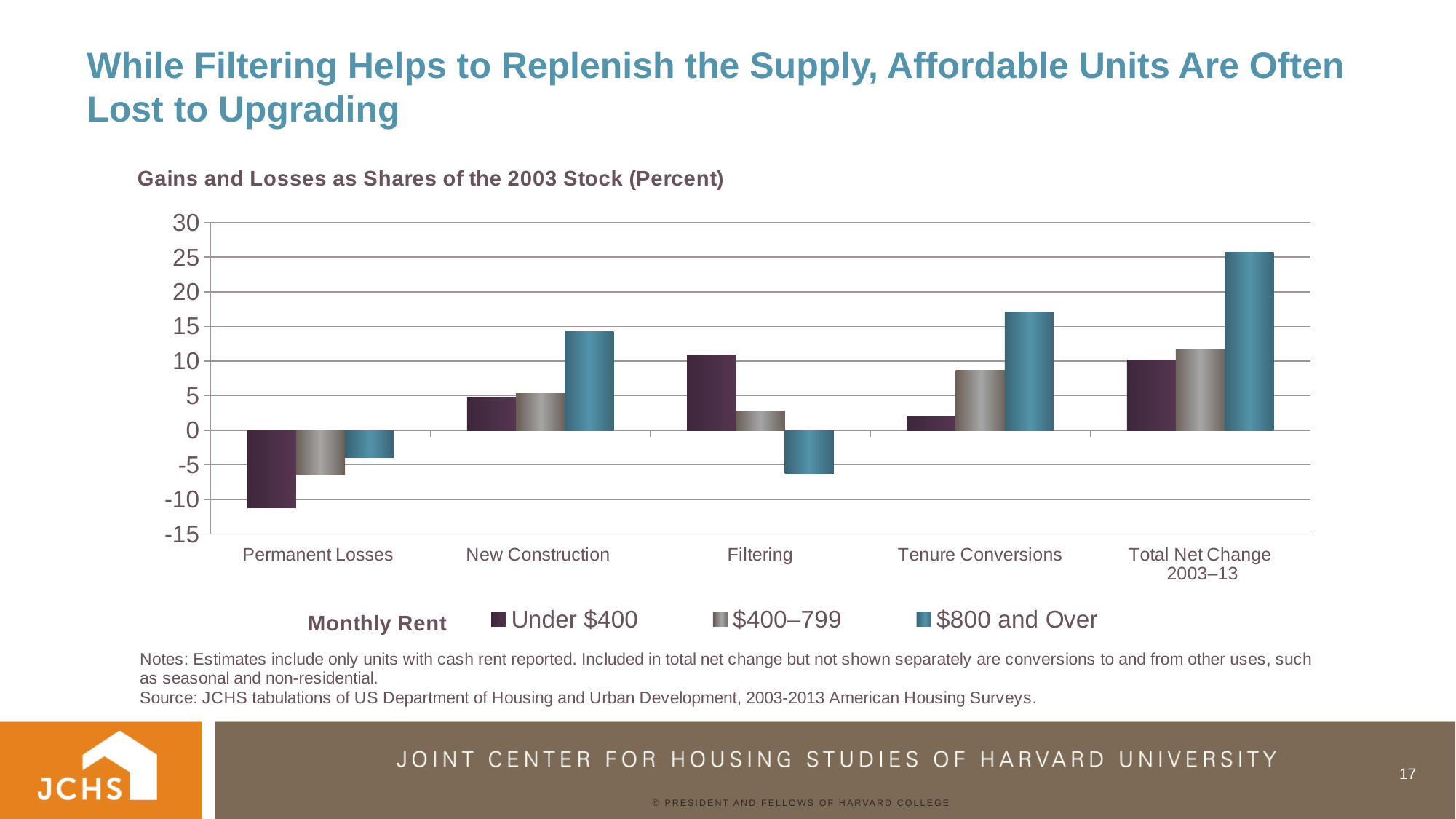
Within the Filtering category, which series has the highest value? Under $400 What kind of chart is shown on the slide? Bar chart How many series does the legend list? 3 Which category has the highest value for the $800 and Over series? Total Net Change 2003–13 For Filtering, which is larger: the Under $400 value or the $800 and Over value? Under $400 Is the value for Under $400 in Permanent Losses greater or less than -10? less How many categories are shown along the x axis? 5 Is the value for $800 and Over in Tenure Conversions greater or less than 15? greater For New Construction, which is larger: the $400–799 value or the $800 and Over value? $800 and Over Is the value for $800 and Over in Total Net Change 2003–13 greater or less than 20? greater Which category has the lowest value for the Under $400 series? Permanent Losses What is the title of the chart? Gains and Losses as Shares of the 2003 Stock (Percent)